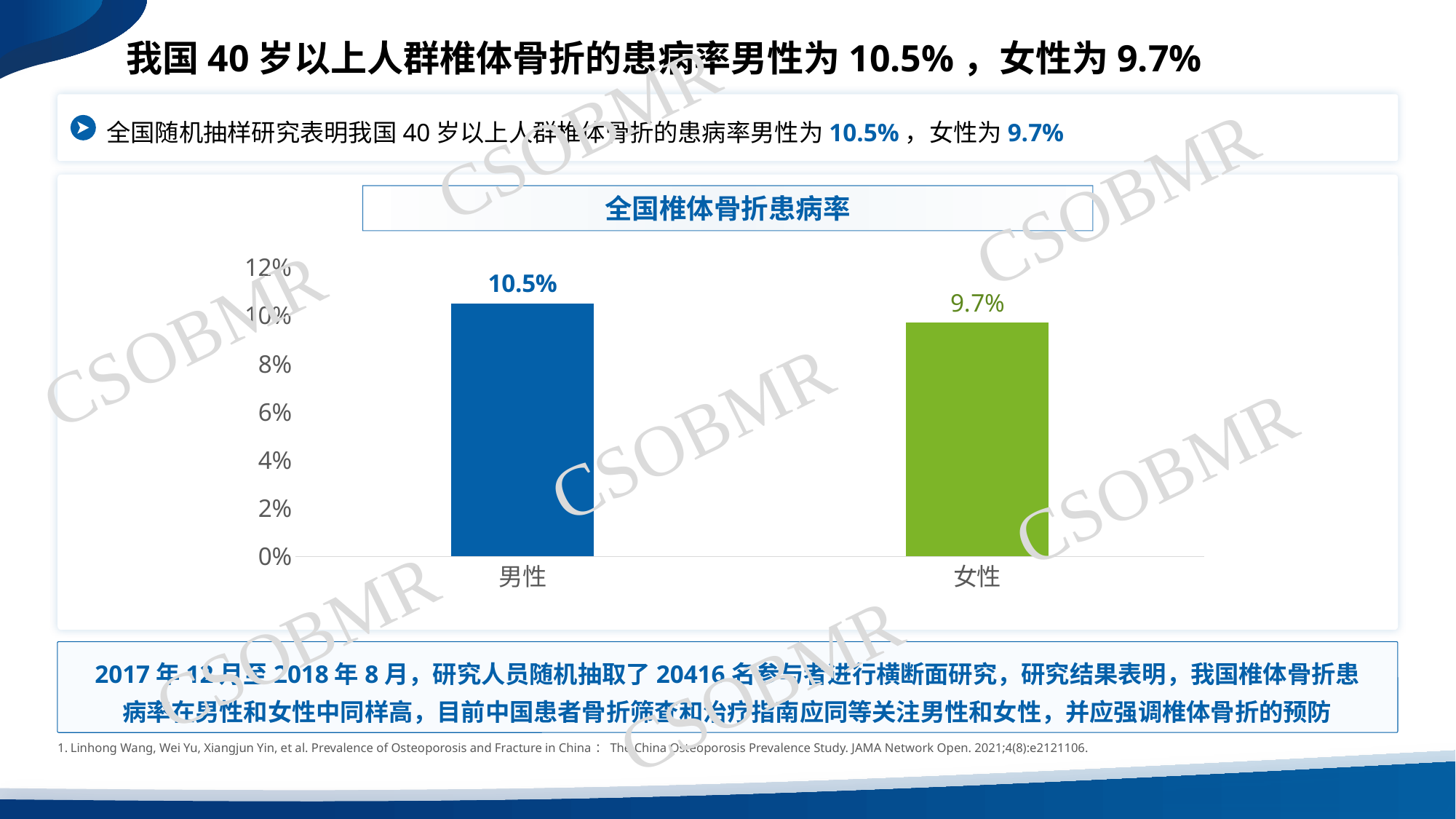
Which category has the lowest value in the chart? 女性 What is the difference between the values for 男性 and 女性? 0.8% What kind of chart is shown on the slide? bar chart What is the value for 男性 in the chart? 10.5% What colour is the bar for 女性? green What is the value for 女性 in the chart? 9.7% Is the value for 男性 greater or less than 10%? greater Which category has the highest value in the chart? 男性 Is the value for 女性 greater or less than 10%? less What is the title of the chart? 全国椎体骨折患病率 How many categories are shown in the chart? 2 Which is larger, the value for 男性 or the value for 女性? 男性